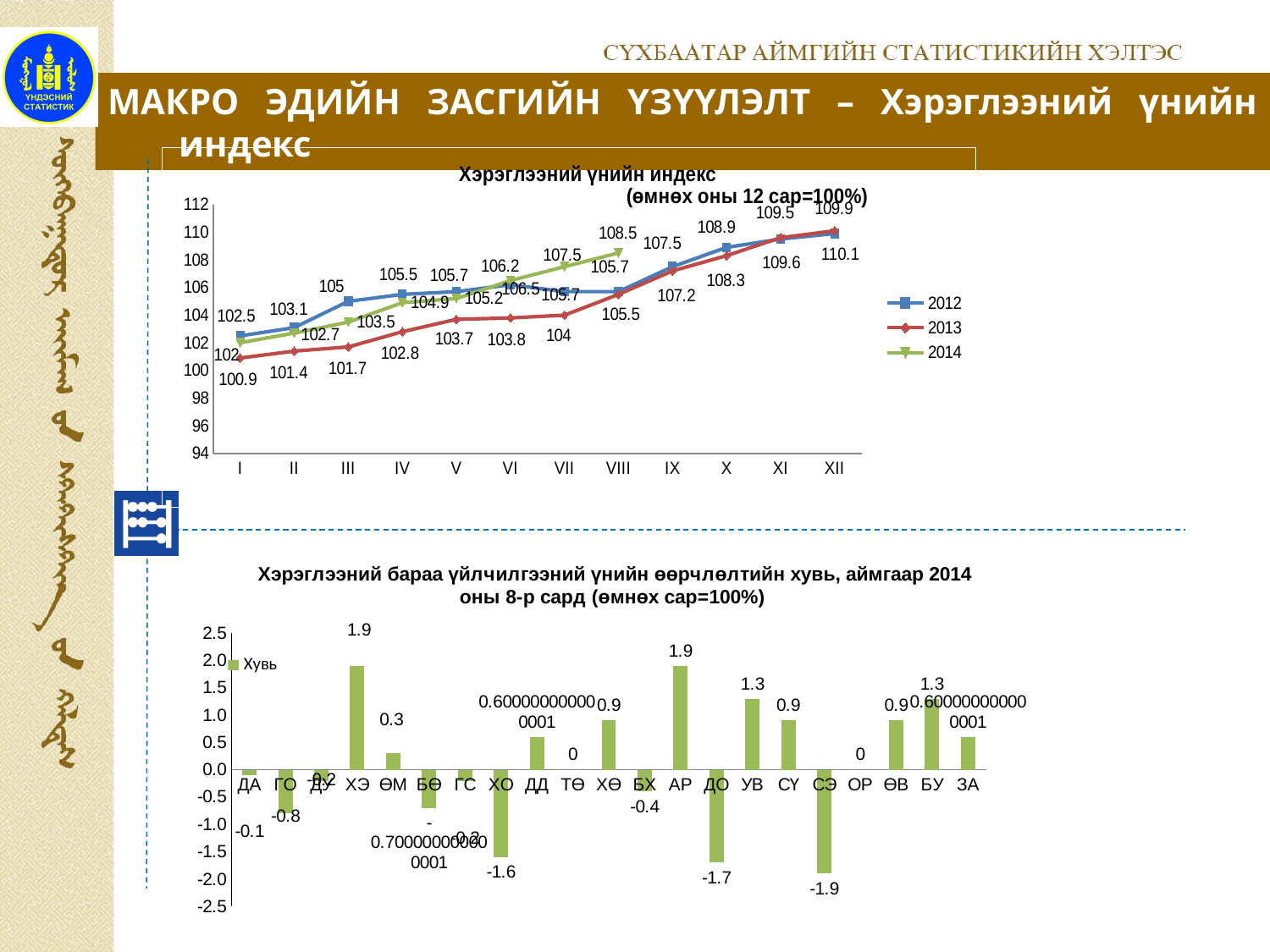
In the top chart 'Хэрэглээний үнийн индекс', what is the value for 2014 in month VIII? 108.5 In the top chart 'Хэрэглээний үнийн индекс', what is the difference between the 2013 and 2012 values in month XII? 0.2 In the top chart 'Хэрэглээний үнийн индекс', what is the value for 2012 in month I? 102.5 In the top chart 'Хэрэглээний үнийн индекс', which series has the higher value in month I, 2012 or 2013? 2012 In the top chart 'Хэрэглээний үнийн индекс', how many series does the legend list? 3 In the bottom bar chart, what is the value for ДО? -1.7 What kind of chart is the bottom chart about price change by aimag in August 2014? bar chart What kind of chart is the top chart titled 'Хэрэглээний үнийн индекс'? line chart In the top chart 'Хэрэглээний үнийн индекс', what is the value for 2013 in month XII? 110.1 In the top chart 'Хэрэглээний үнийн индекс', how many months are shown on the x axis? 12 In the top chart 'Хэрэглээний үнийн индекс', does the 2013 series rise or fall from month I to month XII? rise In the bottom bar chart, which category has the lowest value? СЭ